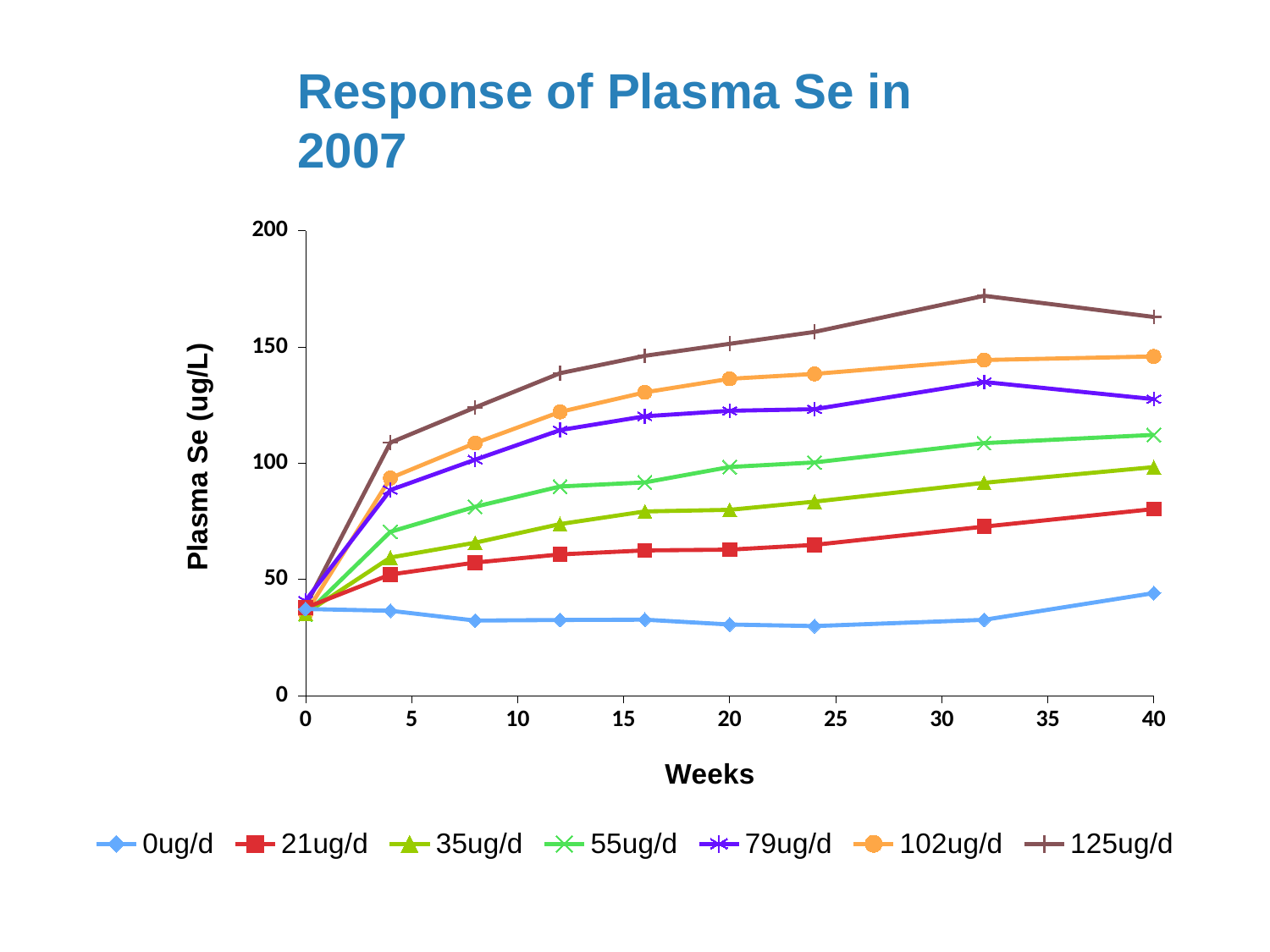
Which series has the lowest plasma Se at week 40? 0ug/d How many data points are plotted for each series? 9 Is the value for 0ug/d at week 24 greater or less than 50? less Is the value for 21ug/d at week 40 greater or less than 50? greater Is the value for 125ug/d at week 32 greater or less than 150? greater Which series has the highest plasma Se at week 40? 125ug/d Does the 102ug/d series generally rise or fall from week 0 to week 40? rise At week 40, which is higher: 125ug/d or 102ug/d? 125ug/d How many series does the legend list? 7 What is the label of the y axis? Plasma Se (ug/L) What kind of chart is shown on the slide? line chart